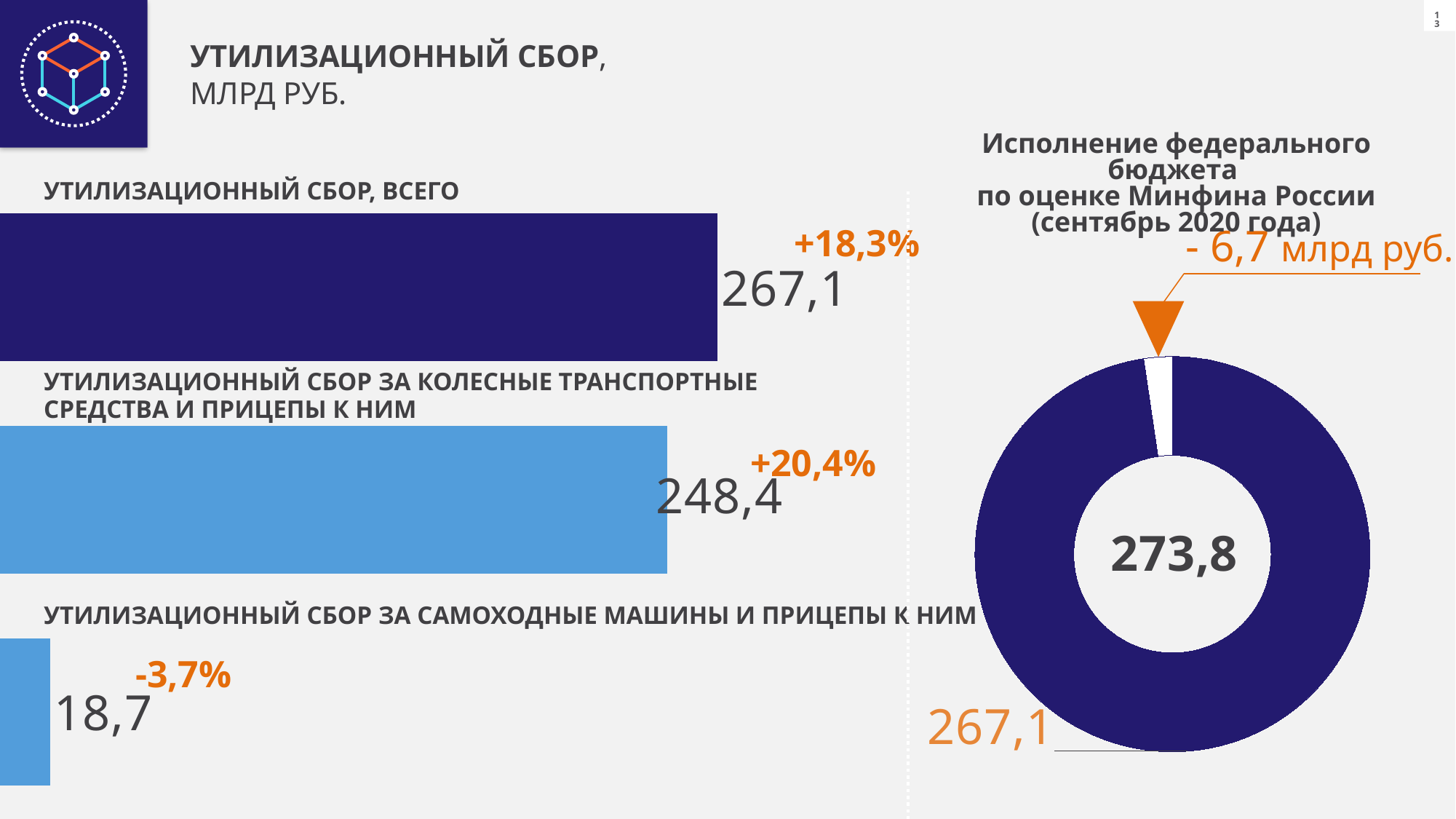
In the bar chart on the left, what is the value for 'УТИЛИЗАЦИОННЫЙ СБОР, ВСЕГО'? 267,1 What kind of chart is shown on the left side of the slide? Bar chart In the bar chart on the left, what is the value for 'УТИЛИЗАЦИОННЫЙ СБОР ЗА САМОХОДНЫЕ МАШИНЫ И ПРИЦЕПЫ К НИМ'? 18,7 In the bar chart on the left, what is the difference between the values for 'УТИЛИЗАЦИОННЫЙ СБОР, ВСЕГО' and 'УТИЛИЗАЦИОННЫЙ СБОР ЗА КОЛЕСНЫЕ ТРАНСПОРТНЫЕ СРЕДСТВА И ПРИЦЕПЫ К НИМ'? 18,7 In the bar chart on the left, which category has the smallest value? УТИЛИЗАЦИОННЫЙ СБОР ЗА САМОХОДНЫЕ МАШИНЫ И ПРИЦЕПЫ К НИМ In the bar chart on the left, what is the value for 'УТИЛИЗАЦИОННЫЙ СБОР ЗА КОЛЕСНЫЕ ТРАНСПОРТНЫЕ СРЕДСТВА И ПРИЦЕПЫ К НИМ'? 248,4 In the bar chart on the left, which category has the largest value? УТИЛИЗАЦИОННЫЙ СБОР, ВСЕГО In the bar chart on the left, how many bars are shown? 3 In the chart on the right titled 'Исполнение федерального бюджета по оценке Минфина России (сентябрь 2020 года)', what difference is labelled next to the small slice? - 6,7 млрд руб. In the chart on the right titled 'Исполнение федерального бюджета по оценке Минфина России (сентябрь 2020 года)', what value is shown in the centre of the ring? 273,8 In the bar chart on the left, what percentage change is shown next to the bar for 'УТИЛИЗАЦИОННЫЙ СБОР, ВСЕГО'? +18,3% In the bar chart on the left, what percentage change is shown next to the bar for 'УТИЛИЗАЦИОННЫЙ СБОР ЗА САМОХОДНЫЕ МАШИНЫ И ПРИЦЕПЫ К НИМ'? -3,7%